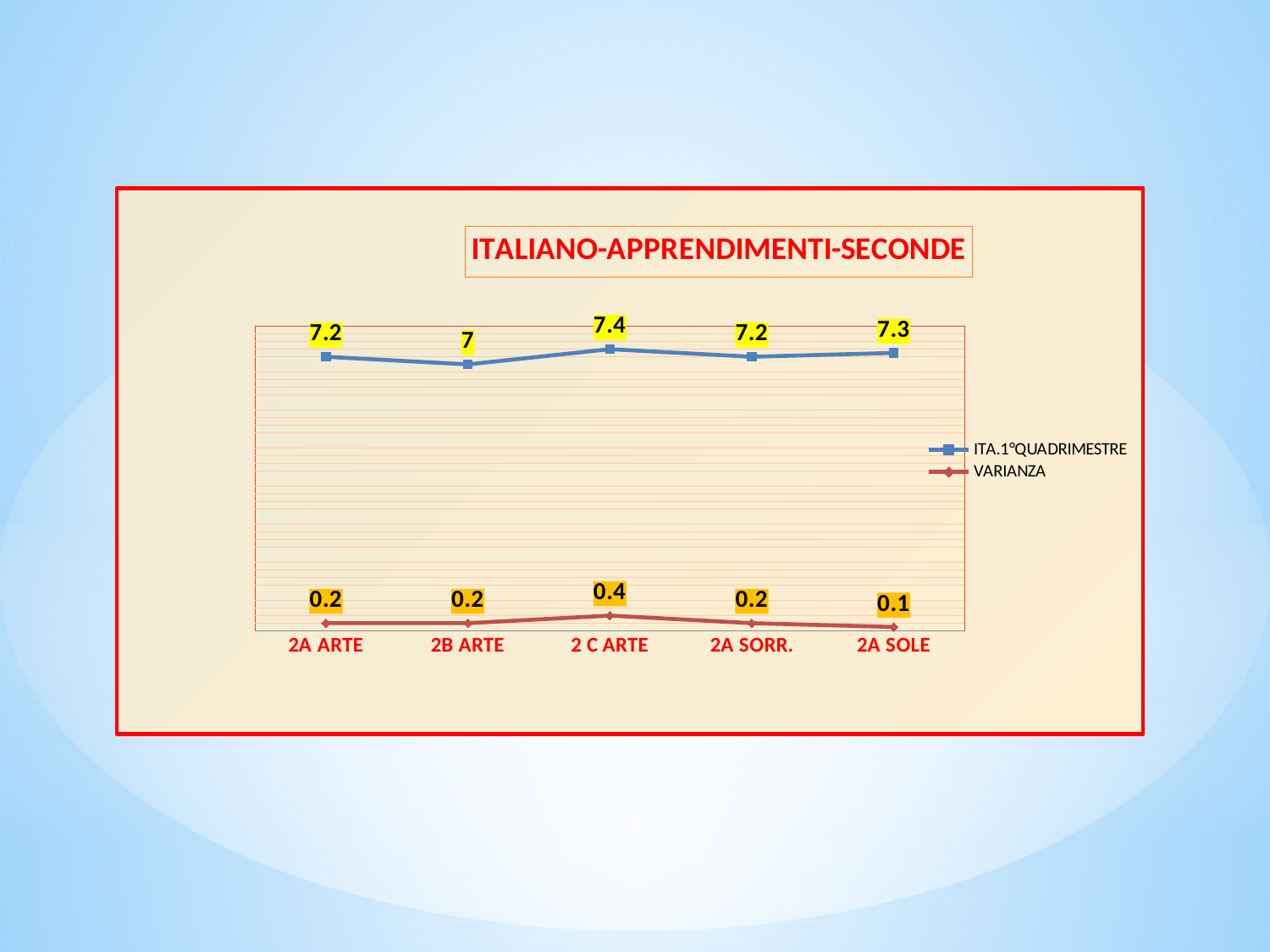
What is the ITA.1°QUADRIMESTRE value for 2B ARTE? 7 Which category has the highest ITA.1°QUADRIMESTRE value? 2 C ARTE What is the ITA.1°QUADRIMESTRE value for 2 C ARTE? 7.4 How many series does the legend list? 2 Which category has the highest VARIANZA value? 2 C ARTE What is the VARIANZA value for 2A SOLE? 0.1 Which is larger, the ITA.1°QUADRIMESTRE value for 2A SOLE or for 2B ARTE? 2A SOLE What is the difference between the ITA.1°QUADRIMESTRE values for 2 C ARTE and 2B ARTE? 0.4 Which category has the lowest ITA.1°QUADRIMESTRE value? 2B ARTE What is the title of the chart? ITALIANO-APPRENDIMENTI-SECONDE How many categories are shown on the x axis? 5 What kind of chart is shown? Line chart